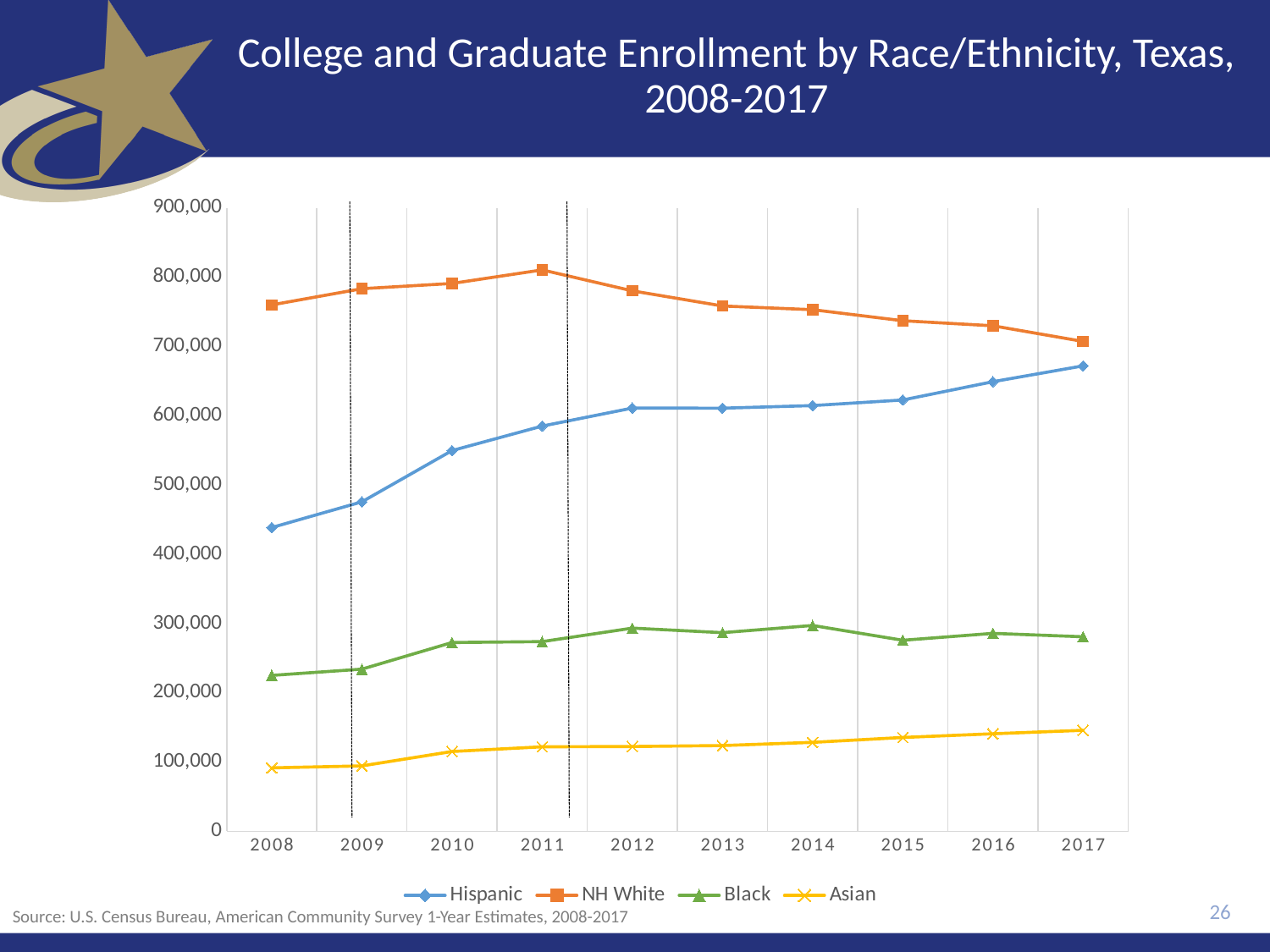
In which year does the Hispanic series reach its highest value? 2017 In which year does the NH White series reach its highest value? 2011 Which race/ethnicity group has the highest enrollment in 2008? NH White What kind of chart is shown on the slide? line chart Is the value for Asian in 2008 greater or less than 100,000? less How many years are plotted along the x axis? 10 Does NH White enrollment rise or fall from 2011 to 2017? fall Does Hispanic enrollment rise or fall from 2008 to 2017? rise Is the value for Hispanic in 2017 greater or less than 600,000? greater Which is larger in 2017, Hispanic enrollment or NH White enrollment? NH White How many series does the legend list? 4 Which race/ethnicity group has the lowest enrollment in 2017? Asian